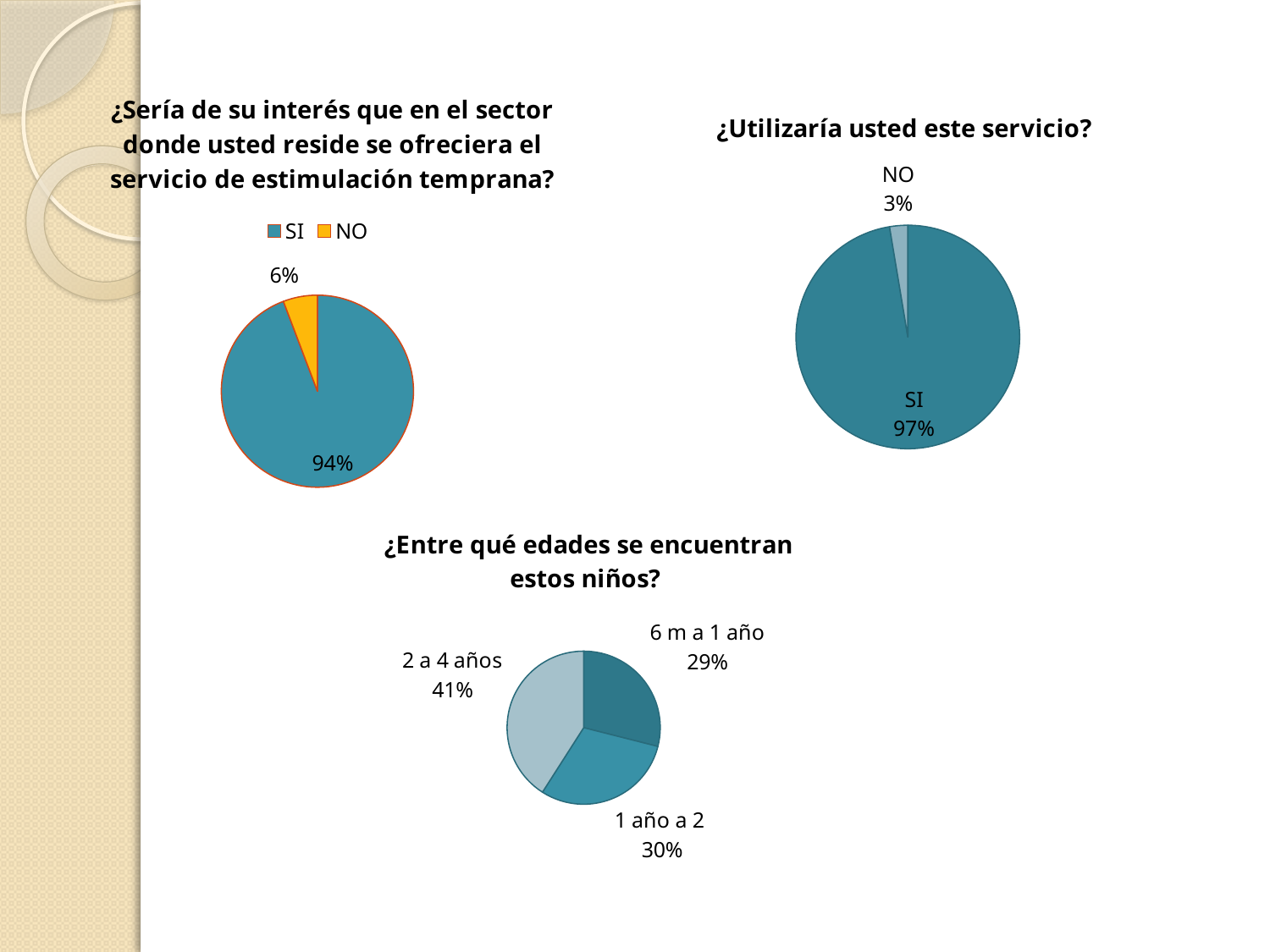
In the chart titled '¿Sería de su interés que en el sector donde usted reside se ofreciera el servicio de estimulación temprana?', what share of the pie is SI? 94% In the chart titled '¿Entre qué edades se encuentran estos niños?', which category has the smallest share? 6 m a 1 año In the chart titled '¿Sería de su interés que en el sector donde usted reside se ofreciera el servicio de estimulación temprana?', what share of the pie is NO? 6% In the chart titled '¿Entre qué edades se encuentran estos niños?', how many categories are shown? 3 In the chart titled '¿Utilizaría usted este servicio?', what is the value for SI? 97% In the chart titled '¿Entre qué edades se encuentran estos niños?', which category has the largest share? 2 a 4 años What kind of chart is the one titled '¿Utilizaría usted este servicio?'? Pie chart In the chart titled '¿Sería de su interés que en el sector donde usted reside se ofreciera el servicio de estimulación temprana?', what colour represents NO in the legend? Orange In the chart titled '¿Entre qué edades se encuentran estos niños?', what is the value for '2 a 4 años'? 41% In the chart titled '¿Utilizaría usted este servicio?', what is the value for NO? 3% In the chart titled '¿Entre qué edades se encuentran estos niños?', what is the value for '6 m a 1 año'? 29% In the chart titled '¿Entre qué edades se encuentran estos niños?', what is the difference between '2 a 4 años' and '1 año a 2'? 11%